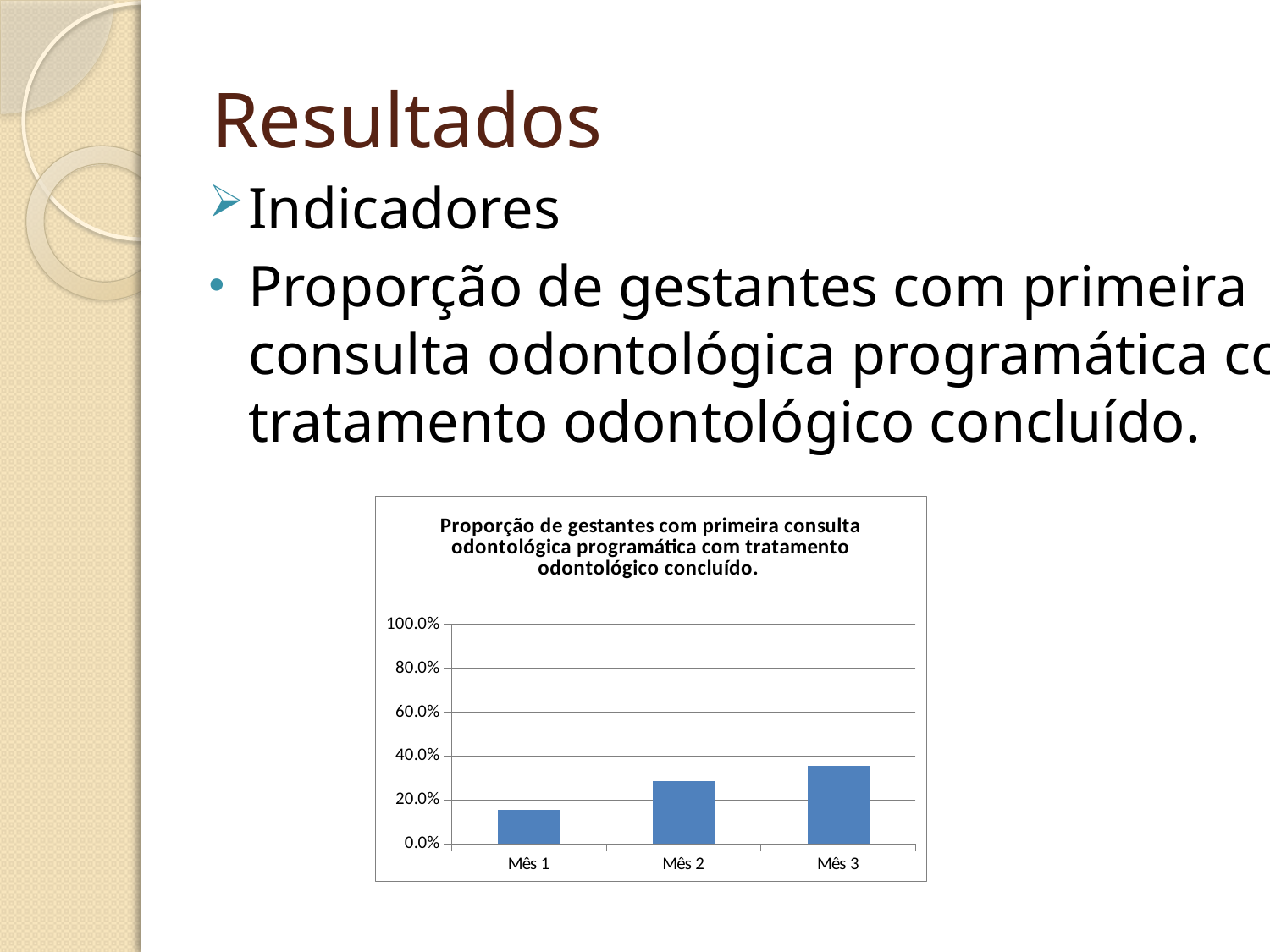
How many categories (months) are plotted on the x axis of the chart? 3 Which month has the highest proportion in the chart? Mês 3 What is the highest value shown on the chart's vertical axis? 100.0% Is the value for Mês 2 greater or less than 20.0%? greater Which is larger, the value for Mês 1 or the value for Mês 2? Mês 2 Which month has the lowest proportion in the chart? Mês 1 Is the value for Mês 3 greater or less than 40.0%? less What kind of chart is shown on the slide? bar chart Do the values rise or fall from Mês 1 to Mês 3? rise Is the value for Mês 1 greater or less than 20.0%? less What colour are the bars in the chart? blue